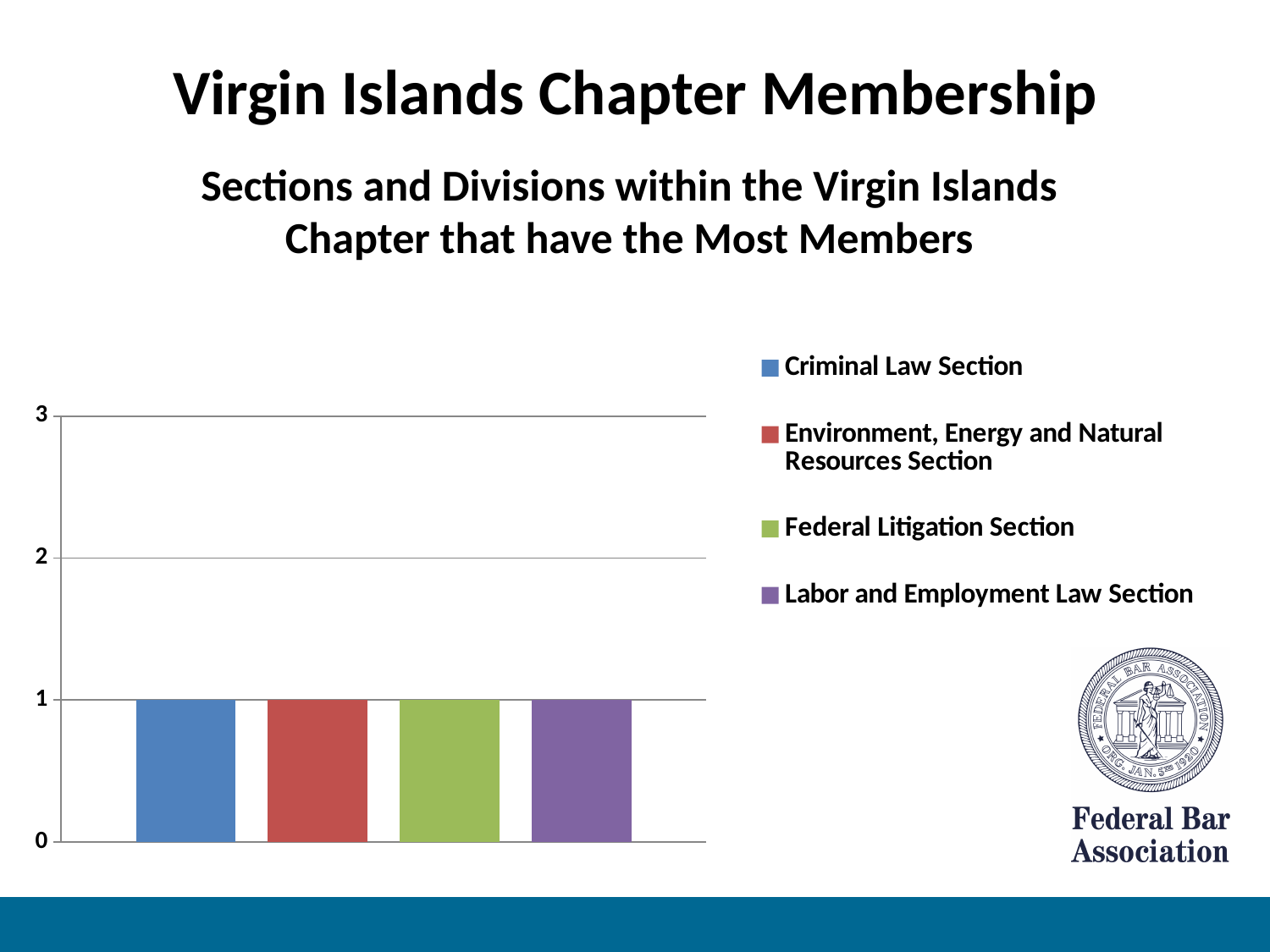
Do the values rise, fall, or stay the same across the bars from left to right? stay the same What is the value for the Criminal Law Section? 1 What is the value for the Environment, Energy and Natural Resources Section? 1 Which colour represents the Federal Litigation Section in the legend? green What is the difference between the values for the Criminal Law Section and the Federal Litigation Section? 0 What is the highest value shown on the vertical axis? 3 What kind of chart is shown on the slide? bar chart What is the value for the Federal Litigation Section? 1 What is the value for the Labor and Employment Law Section? 1 How many series does the legend list? 4 Is the value for the Labor and Employment Law Section greater or less than 2? less How many bars are plotted in the chart? 4